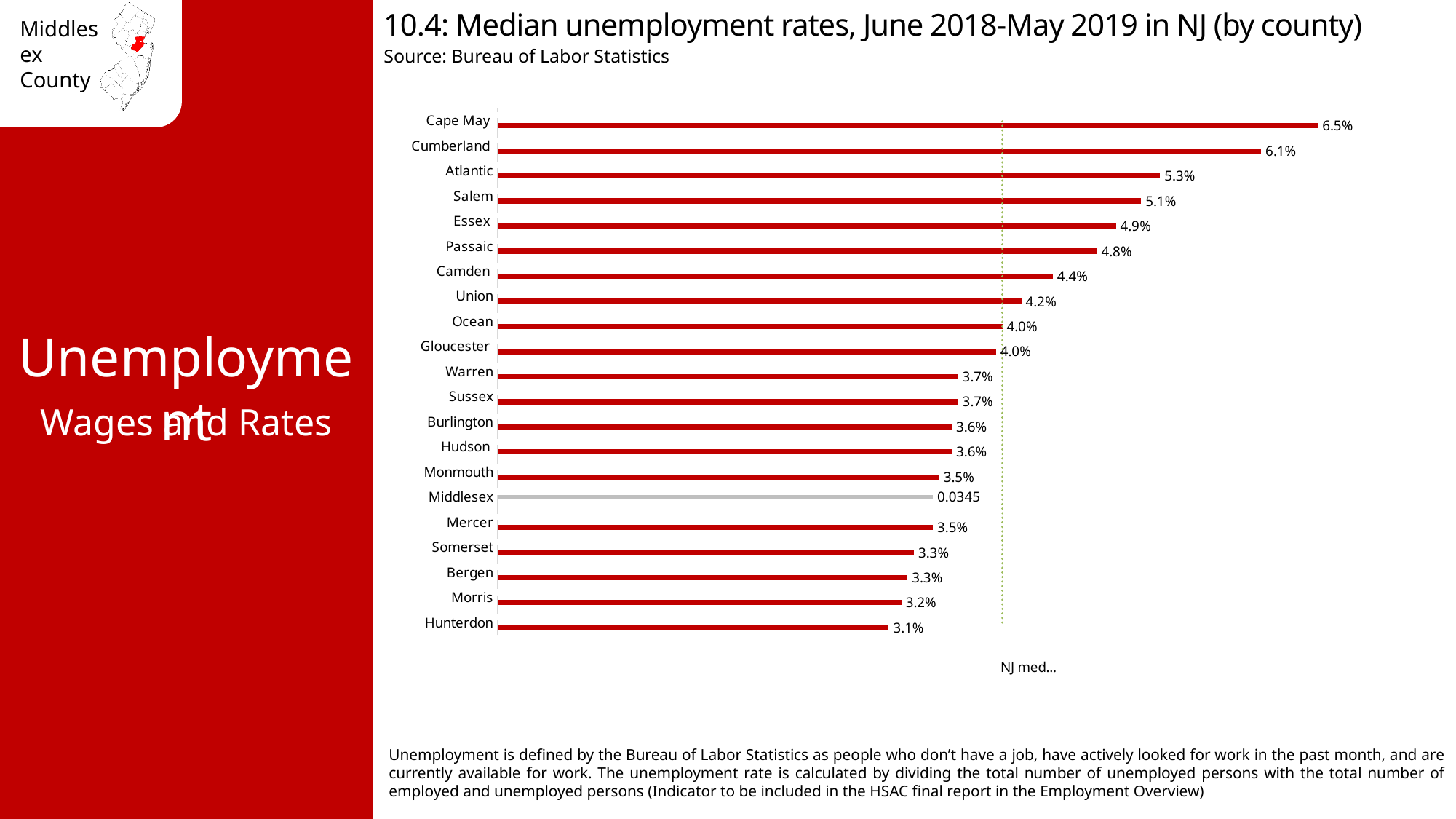
What value is shown for Middlesex? 0.0345 What is the median unemployment rate for Cape May? 6.5% What is the difference in percentage points between Cape May and Hunterdon? 3.4 What is the difference in percentage points between Cumberland and Atlantic? 0.8 What is the source cited for the chart? Bureau of Labor Statistics Which county has the highest median unemployment rate? Cape May Which has a higher median unemployment rate, Camden or Union? Camden Which county has the lowest median unemployment rate? Hunterdon What is the median unemployment rate for Essex? 4.9% How many counties are shown in the chart? 21 What is the median unemployment rate for Hunterdon? 3.1% What kind of chart is shown on the slide? Bar chart